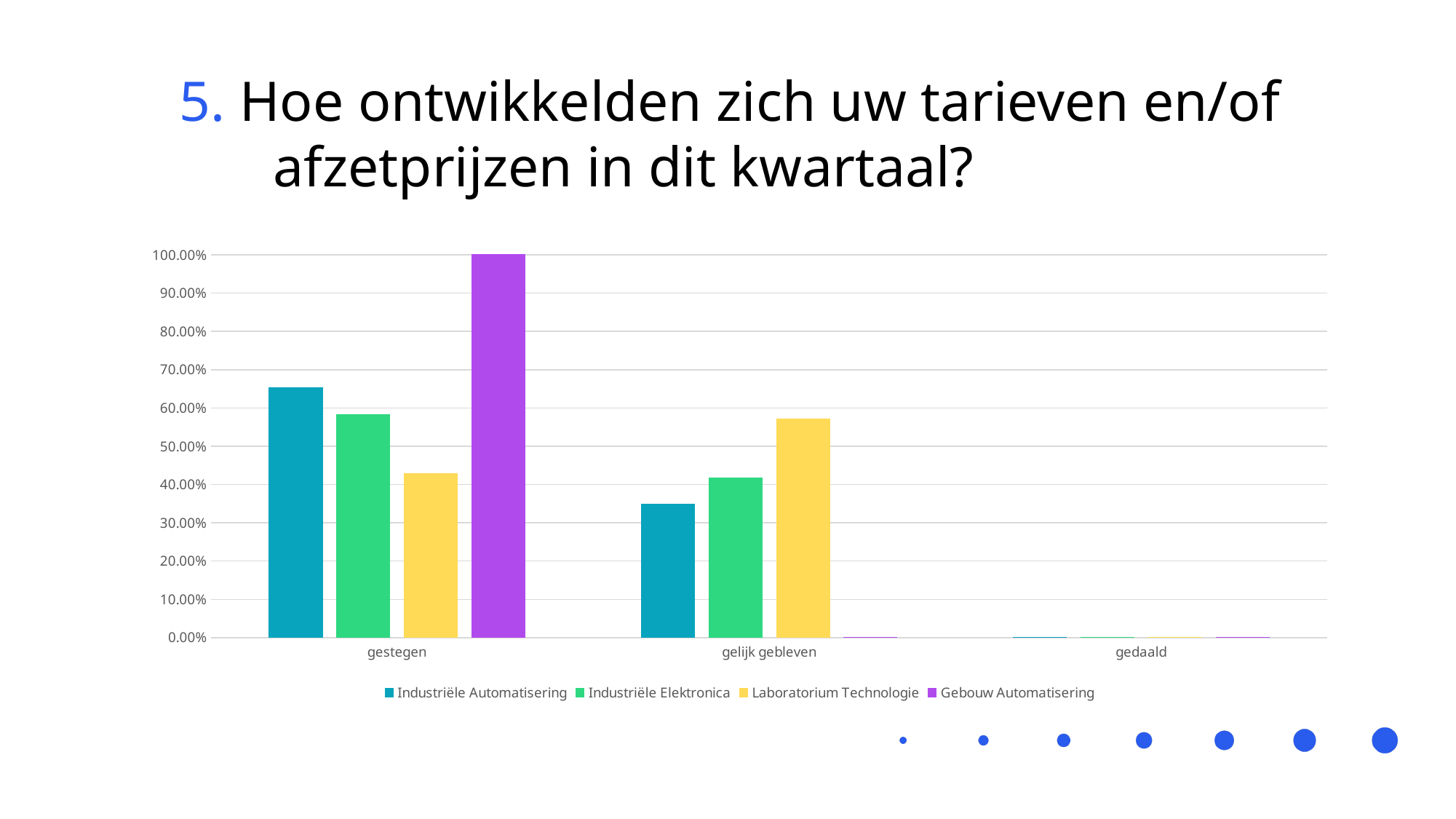
Is the value for Laboratorium Technologie in the 'gestegen' category greater or less than 50.00%? less What colour represents Gebouw Automatisering in the chart? purple In the 'gelijk gebleven' category, which is larger: Industriële Elektronica or Laboratorium Technologie? Laboratorium Technologie How many series does the chart's legend list? 4 Which series has the highest value in the 'gestegen' category? Gebouw Automatisering Is the value for Industriële Automatisering in the 'gestegen' category greater or less than 60.00%? greater Which series has the highest value in the 'gelijk gebleven' category? Laboratorium Technologie What is the value for Gebouw Automatisering in the 'gedaald' category? 0.00% What kind of chart is shown on the slide? bar chart How many categories are shown on the x axis of the chart? 3 Do the values for Industriële Automatisering rise or fall from 'gestegen' to 'gedaald'? fall What is the value for Gebouw Automatisering in the 'gestegen' category? 100.00%